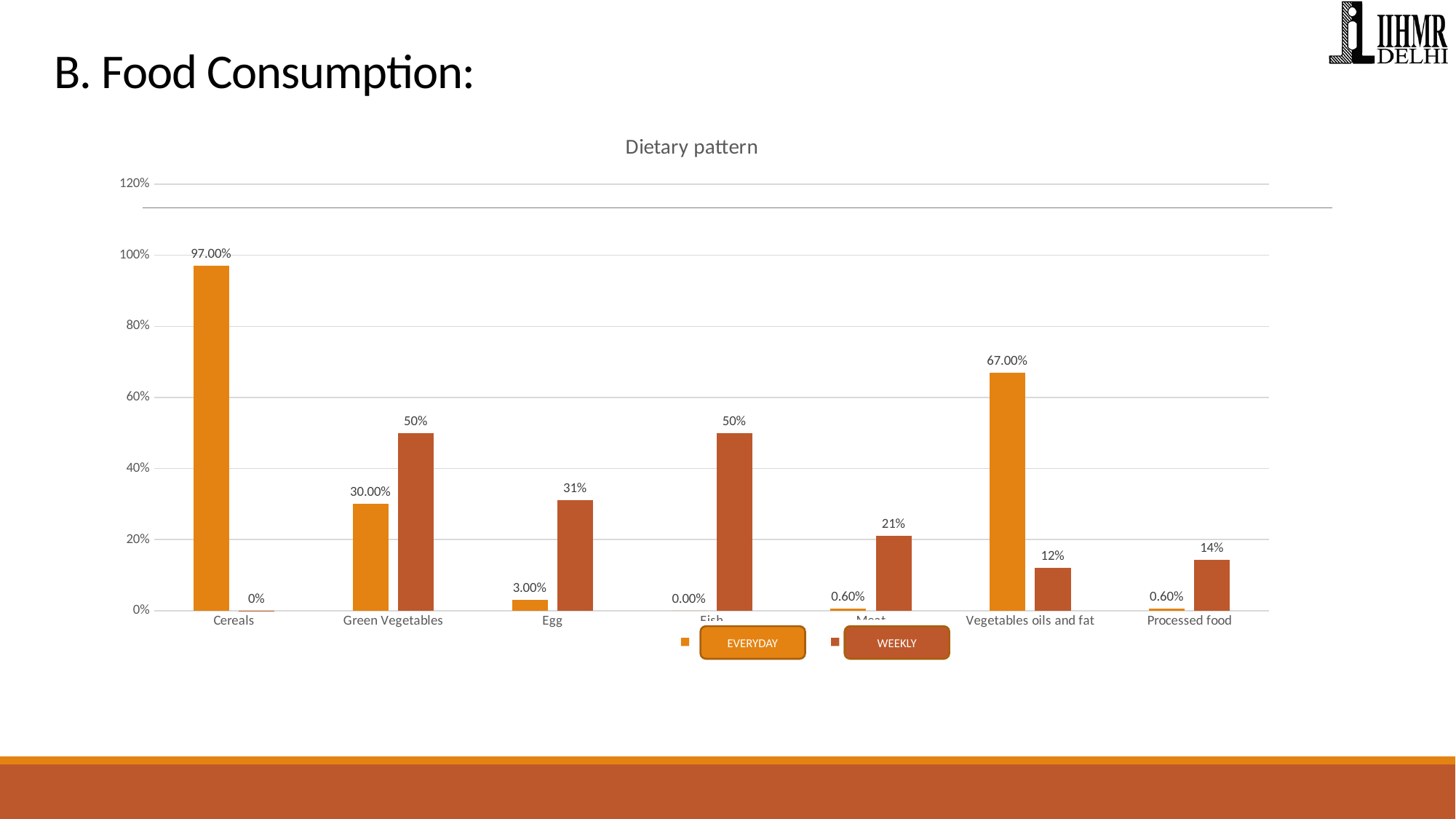
What is the WEEKLY value for Green Vegetables? 50% What is the EVERYDAY value for Cereals? 97.00% How many food categories are shown on the x axis? 7 For Egg, which series has the larger value, EVERYDAY or WEEKLY? WEEKLY What is the difference between the EVERYDAY and WEEKLY values for Vegetables oils and fat? 55% Which category has the highest EVERYDAY value? Cereals Which category has the lowest WEEKLY value? Cereals How many series does the legend list? 2 What is the WEEKLY value for Processed food? 14% What is the EVERYDAY value for Vegetables oils and fat? 67.00% How much higher is the WEEKLY value than the EVERYDAY value for Green Vegetables? 20% Is the EVERYDAY value for Vegetables oils and fat greater or less than 60%? greater